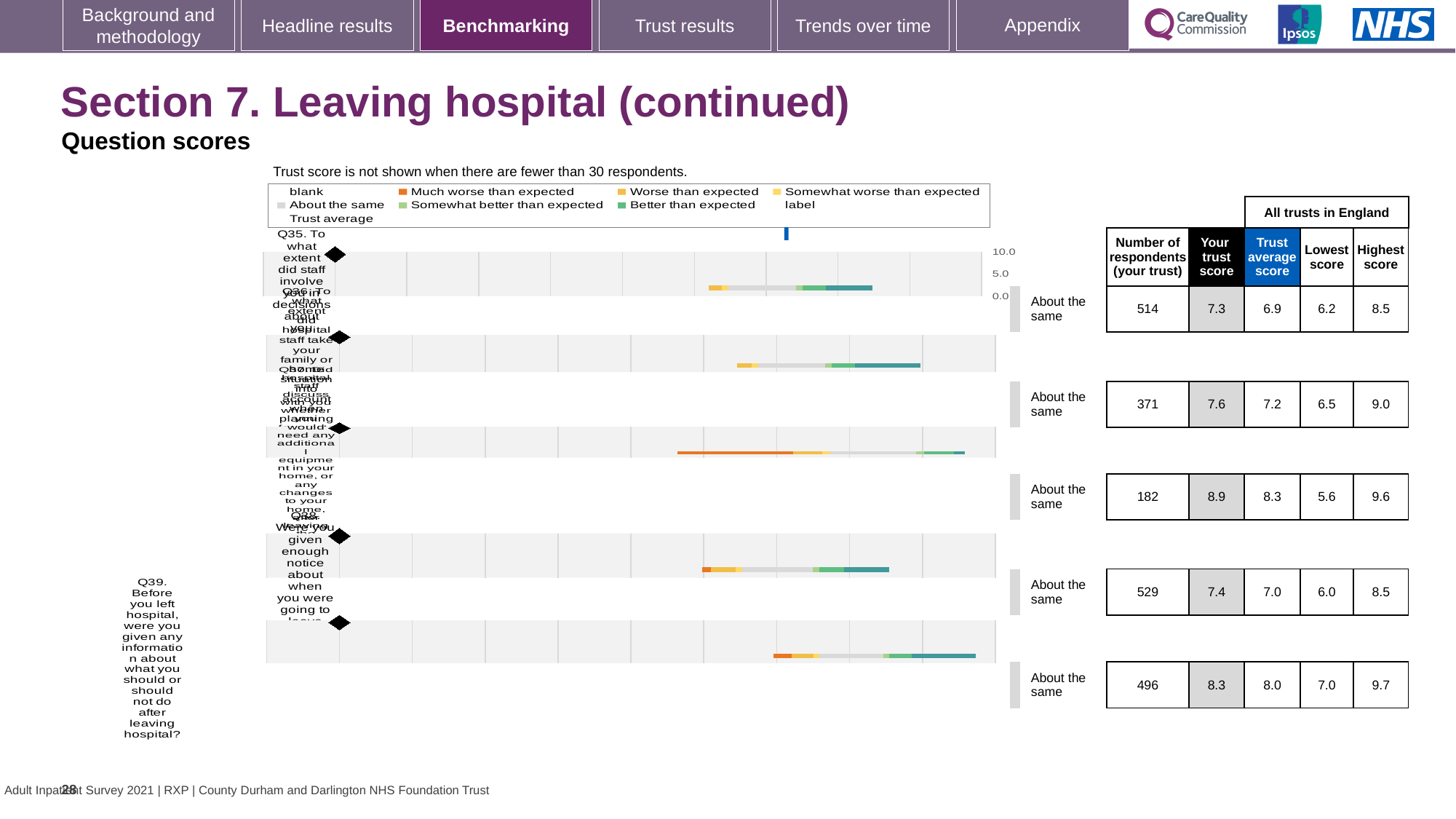
What benchmark category label is shown for Q39 on this slide? About the same What is the difference between your trust score and the trust average score for Q39? 0.3 What is the lowest score across all trusts in England for Q39? 7.0 What is the highest 'Your trust score' value shown in the table on this slide? 8.9 What is your trust score for Q39 (information about what you should or should not do after leaving hospital)? 8.3 For Q39, is your trust score higher or lower than the trust average score? higher What is the trust average score for Q39 (information about what you should or should not do after leaving hospital)? 8.0 How many respondents from your trust answered Q39 (information about what you should or should not do after leaving hospital)? 496 What is the lowest 'Your trust score' value shown in the table on this slide? 7.3 How many questions are plotted in the benchmarking chart on this slide? 5 What kind of chart is used to show the question scores on this slide? bar chart What is the highest score across all trusts in England for Q39? 9.7